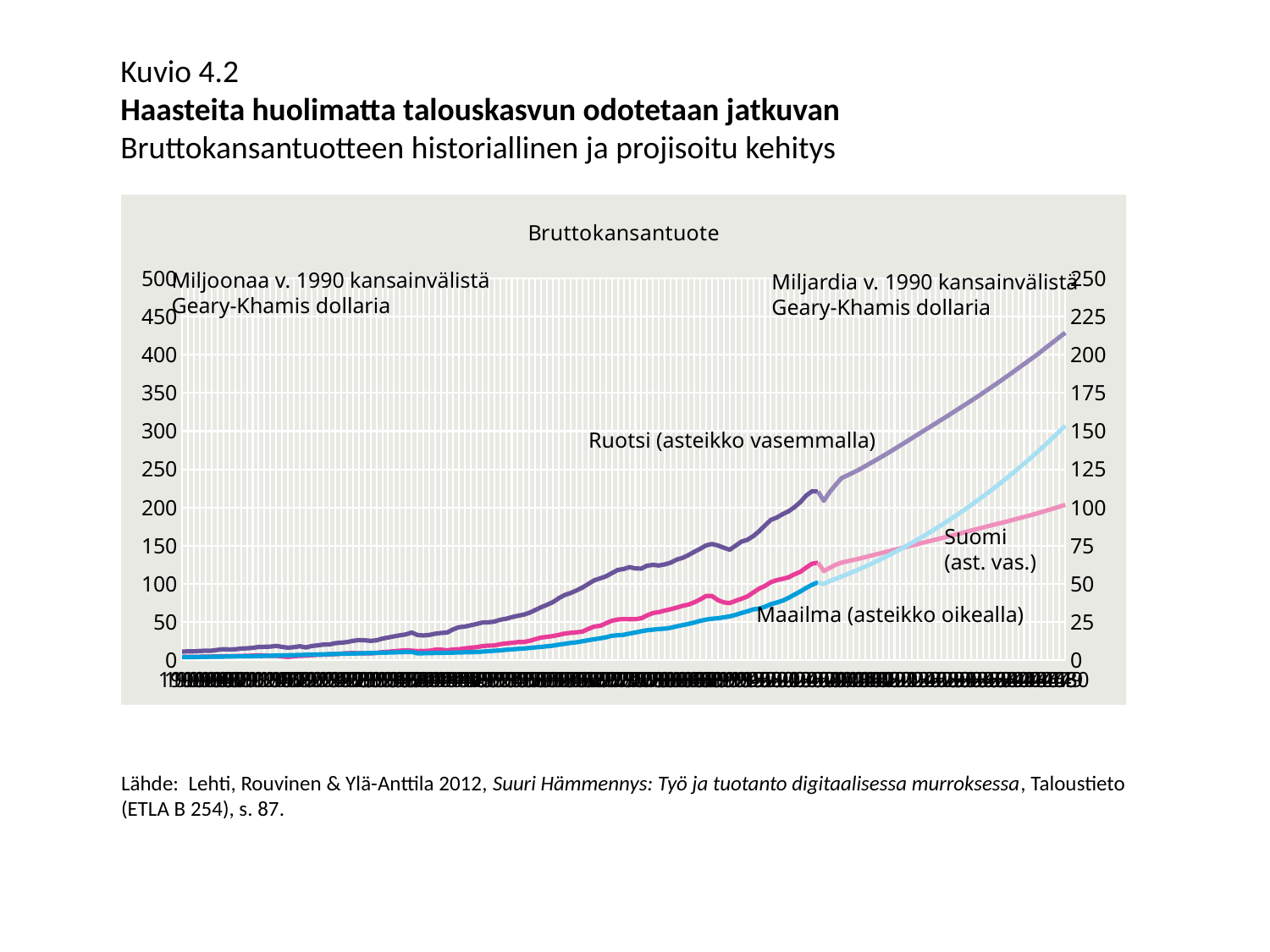
Do the values of the Maailma series generally rise or fall from left to right along the x axis? rise Which of the two series plotted on the left axis, Ruotsi or Suomi, reaches the higher value at the right end of the chart? Ruotsi What is the title printed inside the chart area? Bruttokansantuote Do the values of the Ruotsi series generally rise or fall from left to right along the x axis? rise Is the value of the Ruotsi series at the left end of the chart greater or less than 50 on the left axis? less Which series is plotted against the right-hand axis? Maailma Is the value of the Maailma series at the right end of the chart greater or less than 125 on the right axis? greater Is the value of the Ruotsi series at the right end of the chart greater or less than 400 on the left axis? greater What is the maximum value shown on the right-hand axis? 250 What kind of chart is shown on the slide? line chart